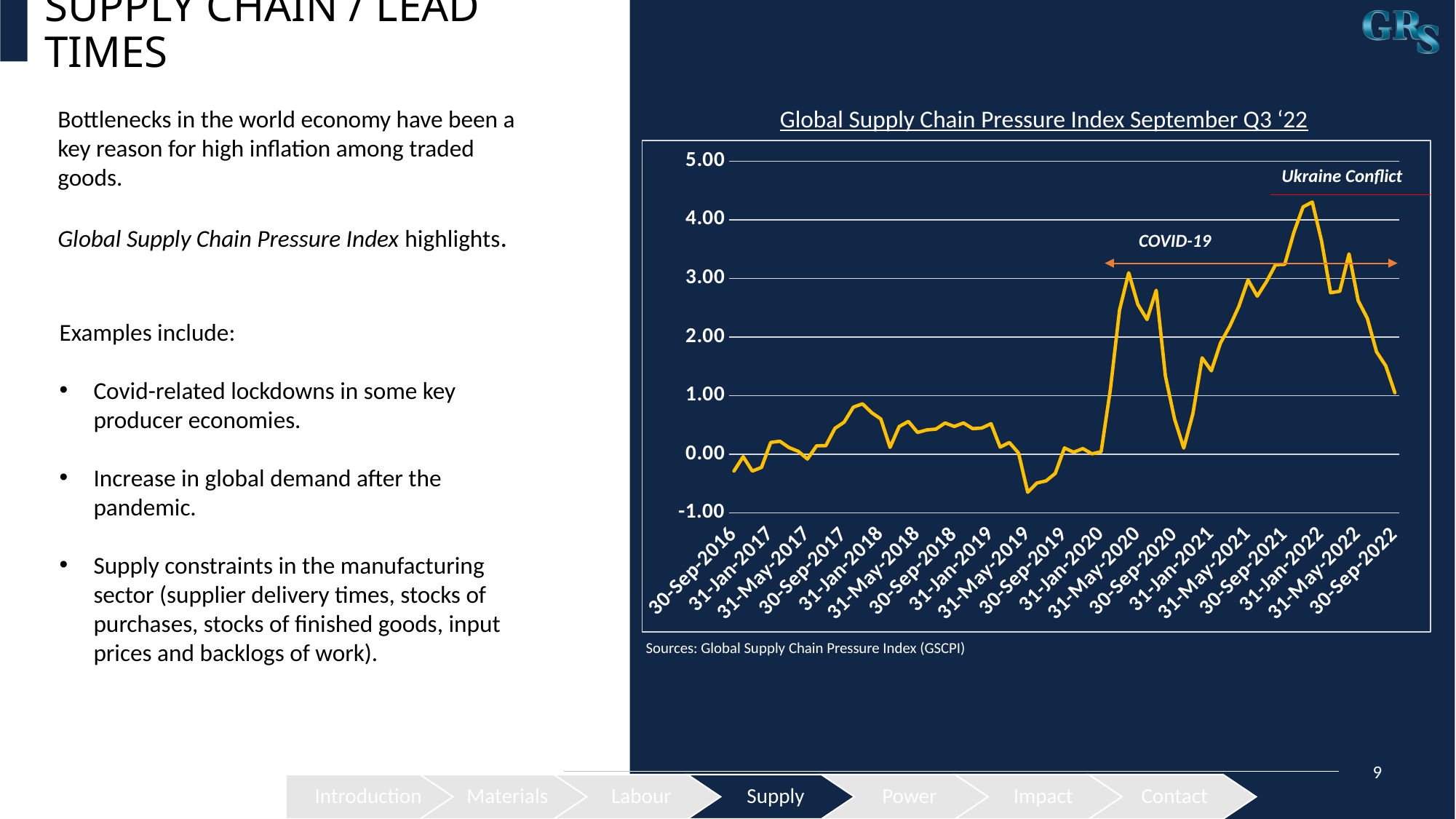
Which is larger, the value for 31-Jan-2022 or the value for 30-Sep-2022? 31-Jan-2022 Is the value for 31-Jan-2022 greater or less than 3.00? greater How many date labels are shown on the x axis of the chart? 19 Between 31-Jan-2022 and 30-Sep-2022, does the line rise or fall overall? fall Is the highest point on the line greater or less than 4.00? greater What kind of chart is shown on the slide? Line chart What is the title of the chart? Global Supply Chain Pressure Index September Q3 '22 What two events are annotated on the chart? COVID-19 and Ukraine Conflict Is the value for 31-May-2019 greater or less than 0.00? less Between 30-Sep-2019 and 31-May-2020, does the line rise or fall overall? rise